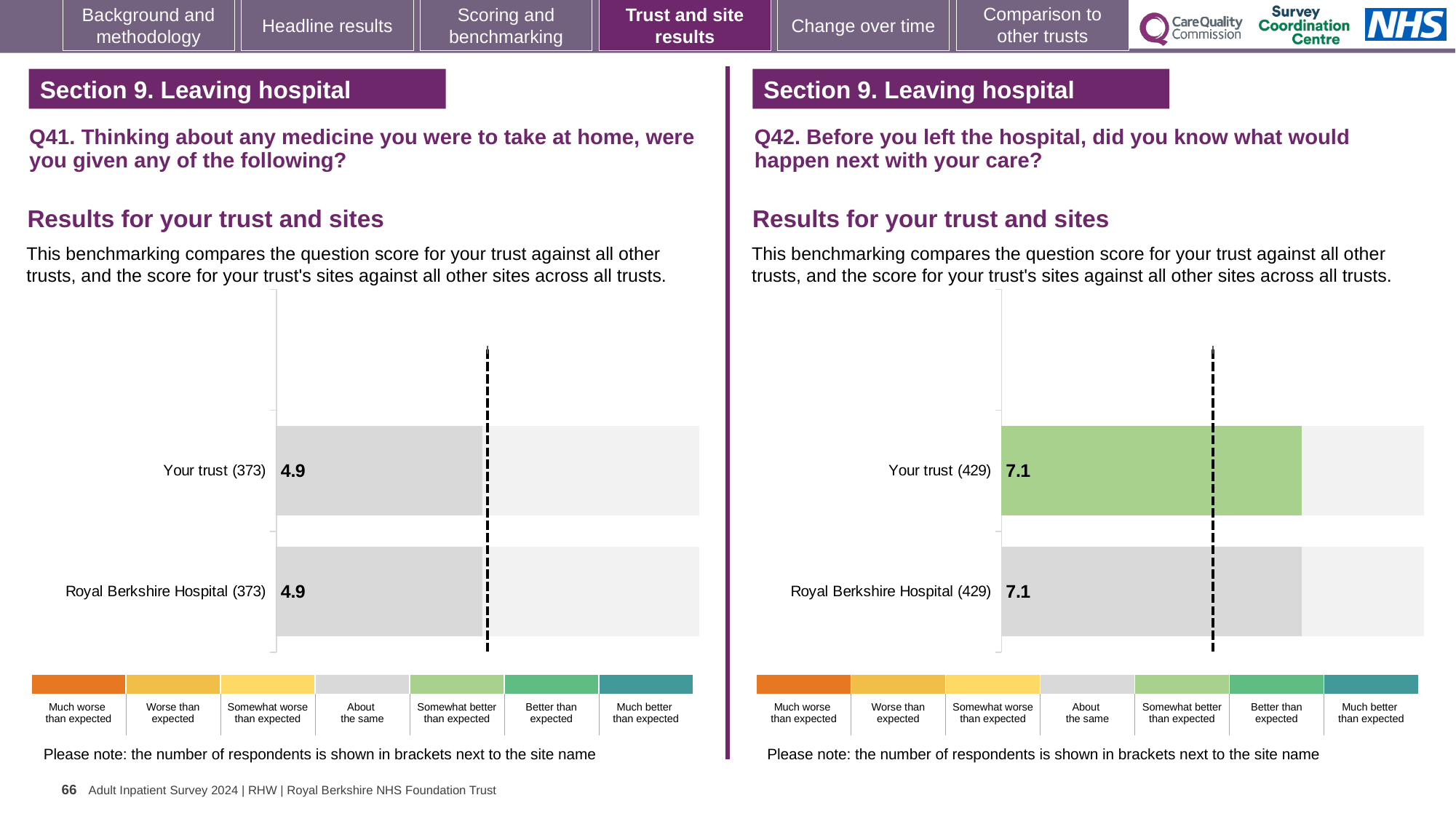
How many bars are plotted in the Q41 chart on the left? 2 In the Q42 chart on the right, what is the difference between the score for Your trust and the score for Royal Berkshire Hospital? 0 In the Q42 chart on the right, which benchmark category does the green colour of the Your trust bar correspond to in the key? Somewhat better than expected In the Q42 chart on the right, how many respondents are shown in brackets next to Royal Berkshire Hospital? 429 What kind of chart is used for the Q42 results on the right? Bar chart In the Q41 chart on the left, how many respondents are shown in brackets next to Your trust? 373 In the Q42 chart on the right, what is the score for Royal Berkshire Hospital? 7.1 In the Q42 chart on the right, what is the score for Your trust? 7.1 In the Q41 chart on the left, what is the score for Your trust? 4.9 In the Q41 chart on the left, what is the score for Royal Berkshire Hospital? 4.9 How many bars are plotted in the Q42 chart on the right? 2 How many benchmark categories are listed in the colour key below the Q41 chart on the left? 7